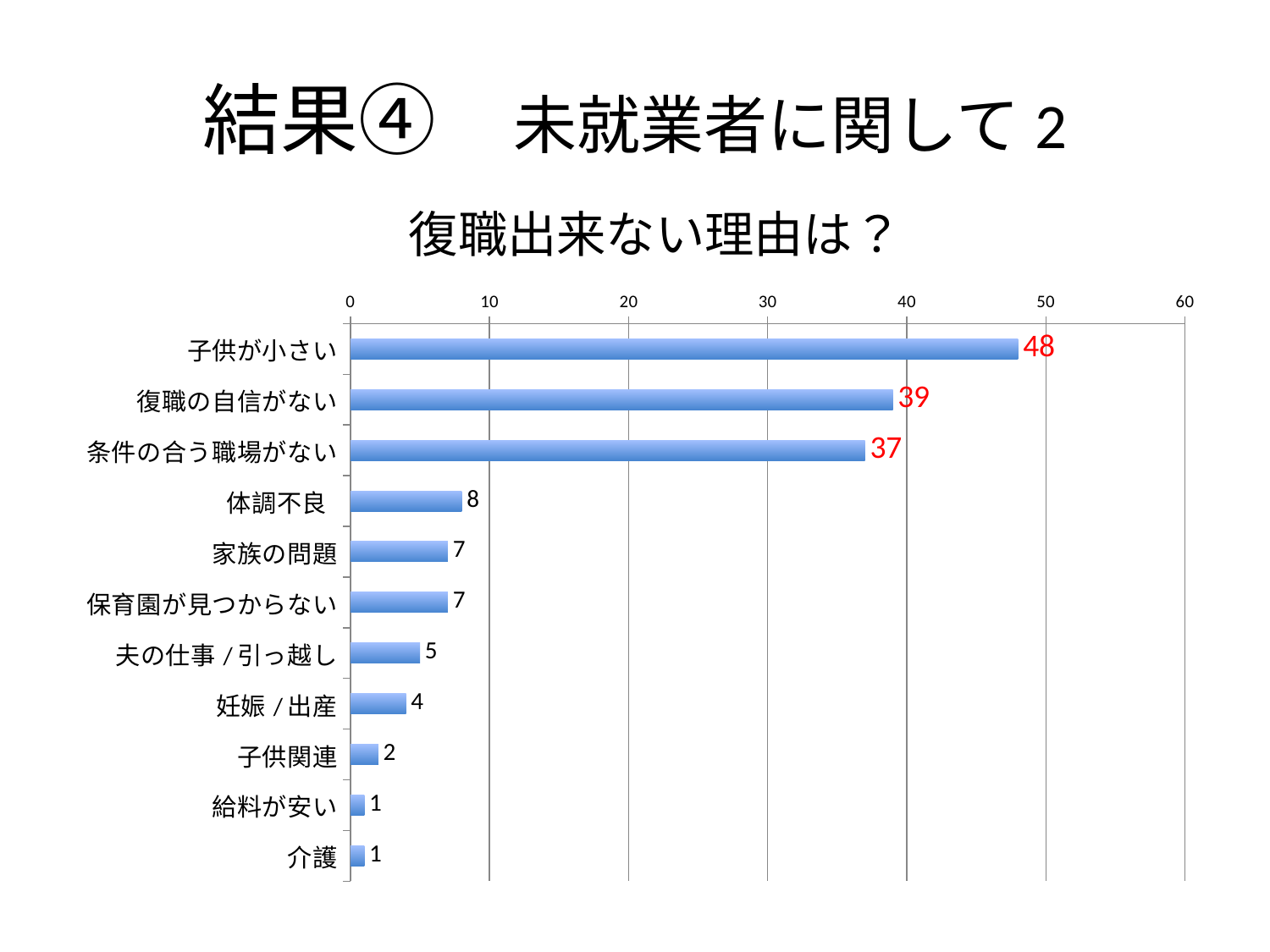
How many categories are shown in the chart? 11 What is the value for 条件の合う職場がない? 37 What is the difference between the values for 子供が小さい and 復職の自信がない? 9 Which category has the highest value? 子供が小さい What is the value for 夫の仕事 / 引っ越し? 5 What is the difference between the values for 復職の自信がない and 条件の合う職場がない? 2 What kind of chart is shown on the slide? bar chart What is the value for 体調不良? 8 Is the value for 復職の自信がない greater or less than 30? greater Which is larger, the value for 体調不良 or the value for 妊娠 / 出産? 体調不良 What is the title of the chart? 復職出来ない理由は？ What is the value for 子供が小さい? 48